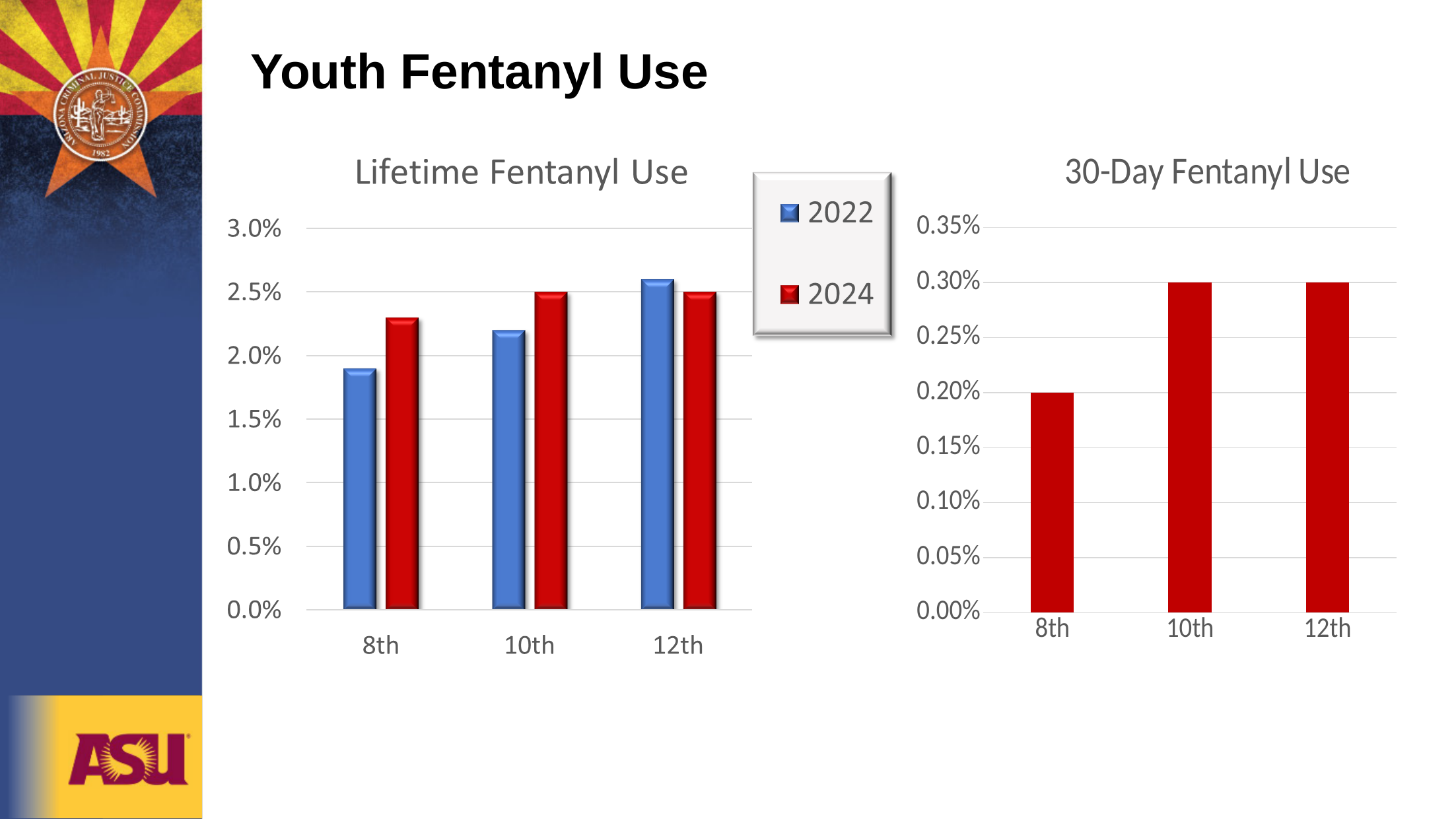
In the Lifetime Fentanyl Use chart, which is larger for 8th grade, the 2022 value or the 2024 value? 2024 In the Lifetime Fentanyl Use chart, how many series does the legend list? 2 What kind of chart is the 30-Day Fentanyl Use chart? bar chart In the Lifetime Fentanyl Use chart, do the 2022 values rise or fall from 8th to 12th grade? rise In the Lifetime Fentanyl Use chart, is the 2022 value for 8th grade greater or less than 2.0%? less In the Lifetime Fentanyl Use chart, is the 2024 value for 8th grade greater or less than 2.0%? greater In the 30-Day Fentanyl Use chart, what is the value for 8th grade? 0.20% In the 30-Day Fentanyl Use chart, what is the difference between the 10th grade and 8th grade values? 0.10% In the 30-Day Fentanyl Use chart, which grade has the lowest value? 8th In the Lifetime Fentanyl Use chart, is the 2022 value for 12th grade greater or less than 2.5%? greater In the 30-Day Fentanyl Use chart, what is the value for 10th grade? 0.30% In the Lifetime Fentanyl Use chart, which grade has the highest 2022 value? 12th